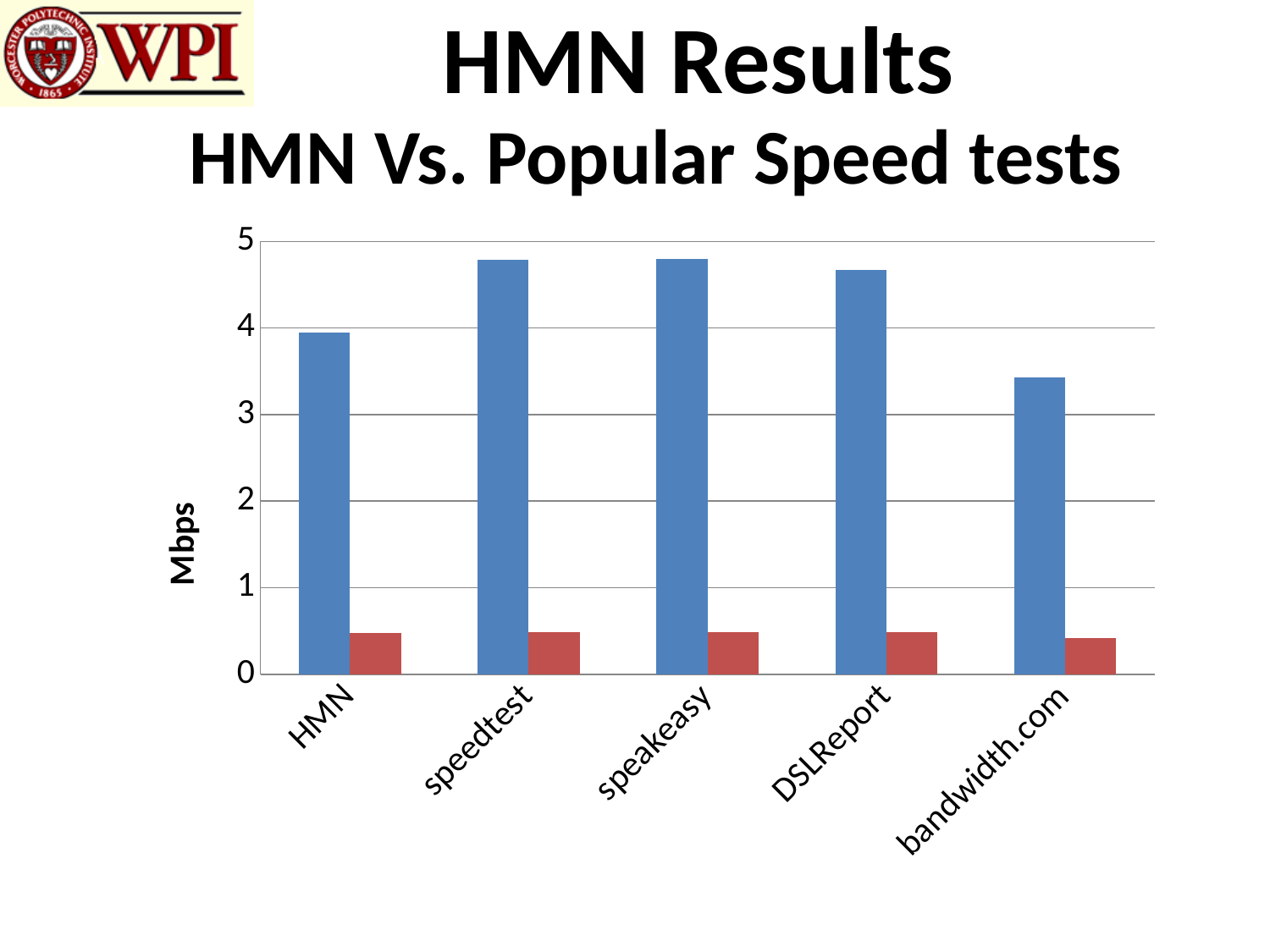
Is the blue bar for HMN greater or less than 3? greater Which category has the lowest blue bar? bandwidth.com Which has the larger blue bar, DSLReport or HMN? DSLReport Is the blue bar for bandwidth.com greater or less than 4? less Is the blue bar for speedtest greater or less than 4? greater Which has the larger blue bar, HMN or bandwidth.com? HMN What is the label on the vertical axis of the chart? Mbps How many categories are shown on the x axis of the chart? 5 How many bars are plotted for each category in the chart? 2 What is the title of the chart? HMN Vs. Popular Speed tests What kind of chart is shown on the slide? bar chart